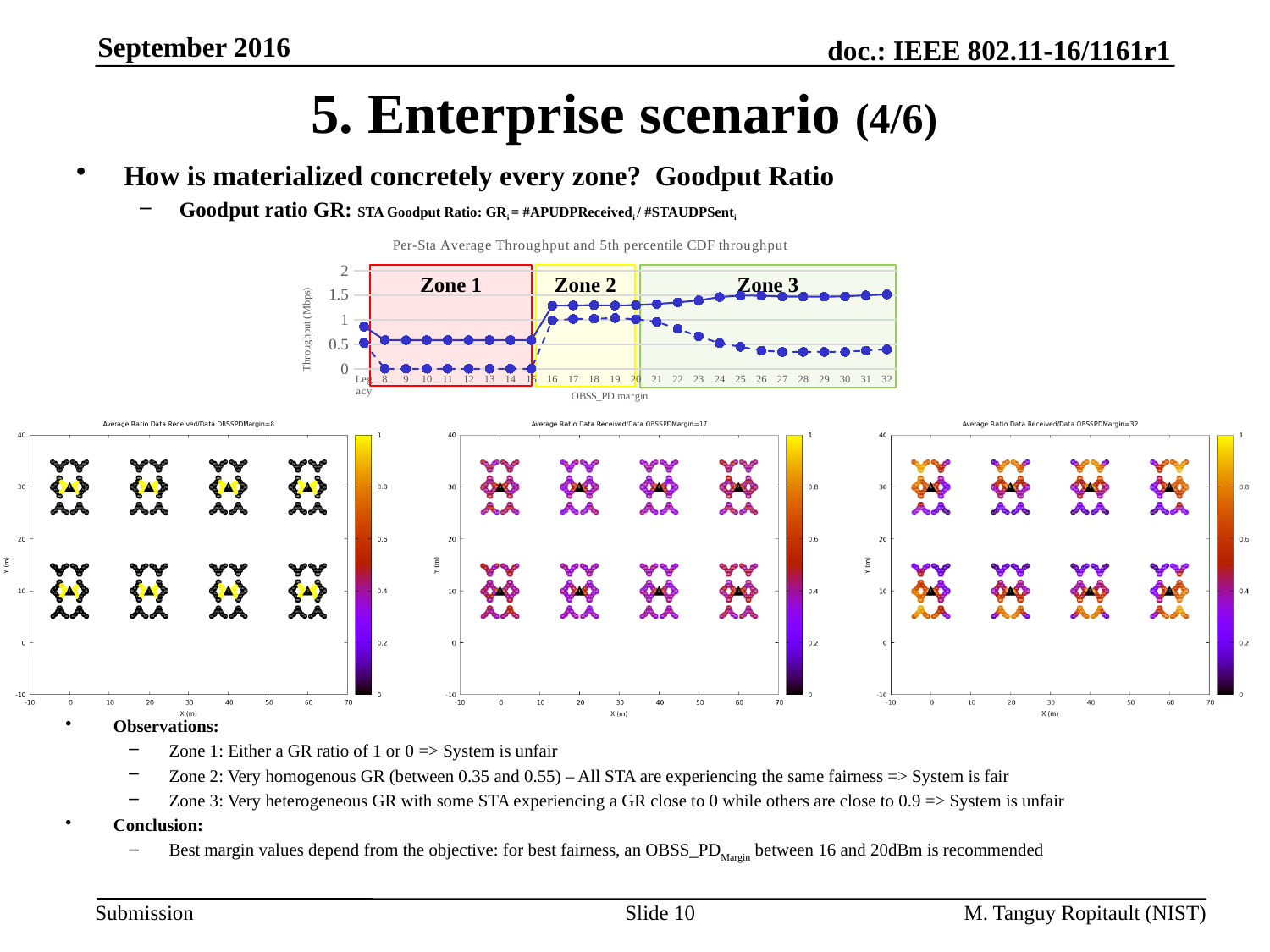
In the throughput line chart, how many zones are marked on the plot? 3 What kind of chart is the 'Per-Sta Average Throughput and 5th percentile CDF throughput' chart? line chart What is the x-axis label of the throughput line chart? OBSS_PD margin In the throughput line chart, is the value of the solid line at OBSS_PD margin 32 greater or less than 1? greater In the throughput line chart, does the dashed line rise or fall as the OBSS_PD margin increases from 21 to 32? fall In the throughput line chart, is the value of the dashed line at OBSS_PD margin 17 greater or less than 0.5? greater In the throughput line chart, does the solid line rise or fall as the OBSS_PD margin increases from 16 to 32? rise In the throughput line chart, is the value of the solid line at OBSS_PD margin 10 greater or less than 1? less In the throughput line chart, at OBSS_PD margin 32, which line is higher, the solid line or the dashed line? solid line In the throughput line chart, how many tick labels are shown on the x axis (including 'Legacy')? 26